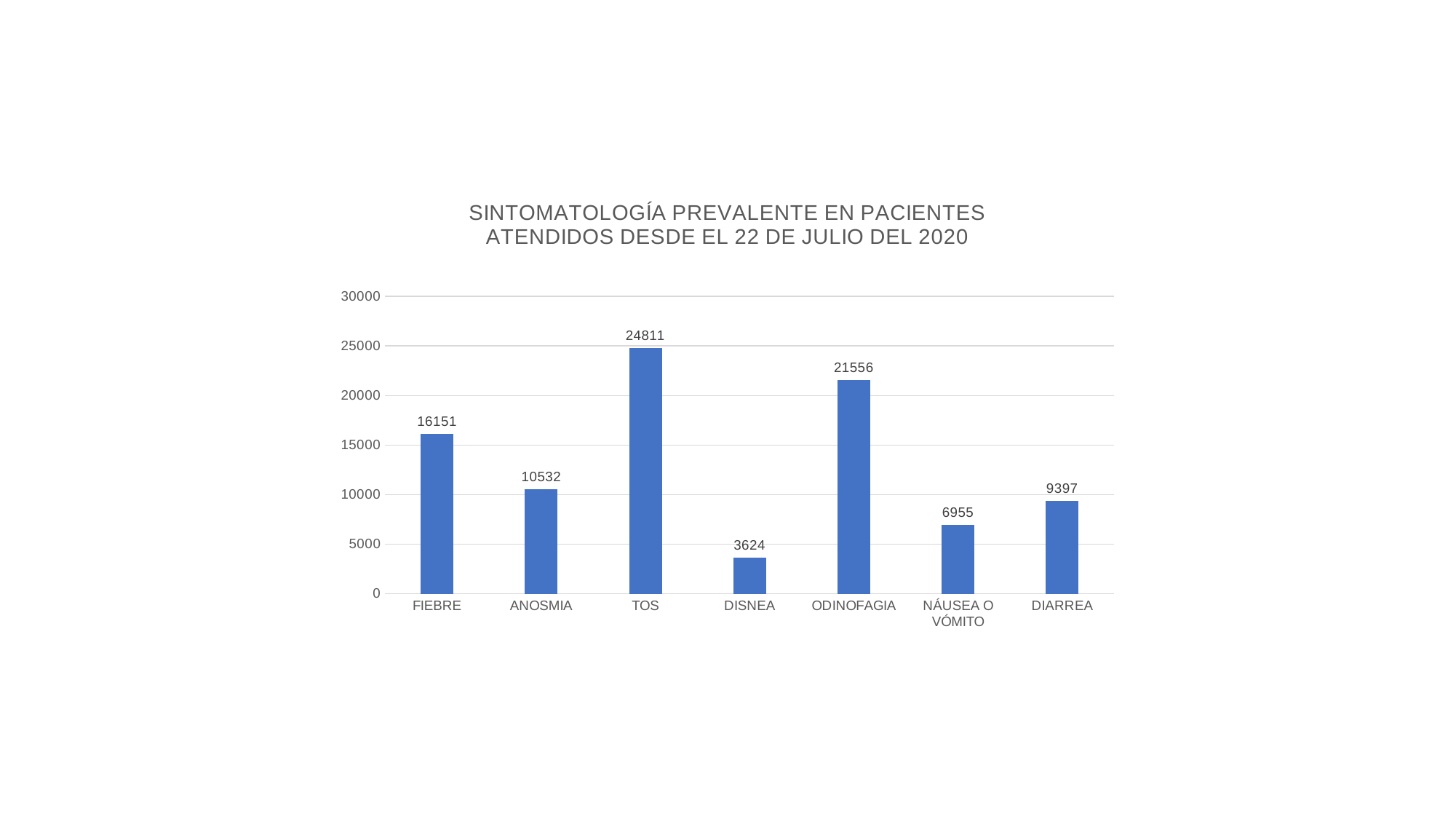
What is the title of the chart? SINTOMATOLOGÍA PREVALENTE EN PACIENTES ATENDIDOS DESDE EL 22 DE JULIO DEL 2020 What kind of chart is shown on the slide? bar chart Which symptom has the lowest value? DISNEA Is the value for ODINOFAGIA greater or less than 20000? greater What is the value for FIEBRE? 16151 What is the value for NÁUSEA O VÓMITO? 6955 Which symptom has the highest value? TOS What is the difference between the values for TOS and ODINOFAGIA? 3255 Which is larger, the value for FIEBRE or the value for ANOSMIA? FIEBRE How many symptom categories are shown on the chart? 7 What is the difference between the values for ANOSMIA and DIARREA? 1135 What is the value for TOS? 24811